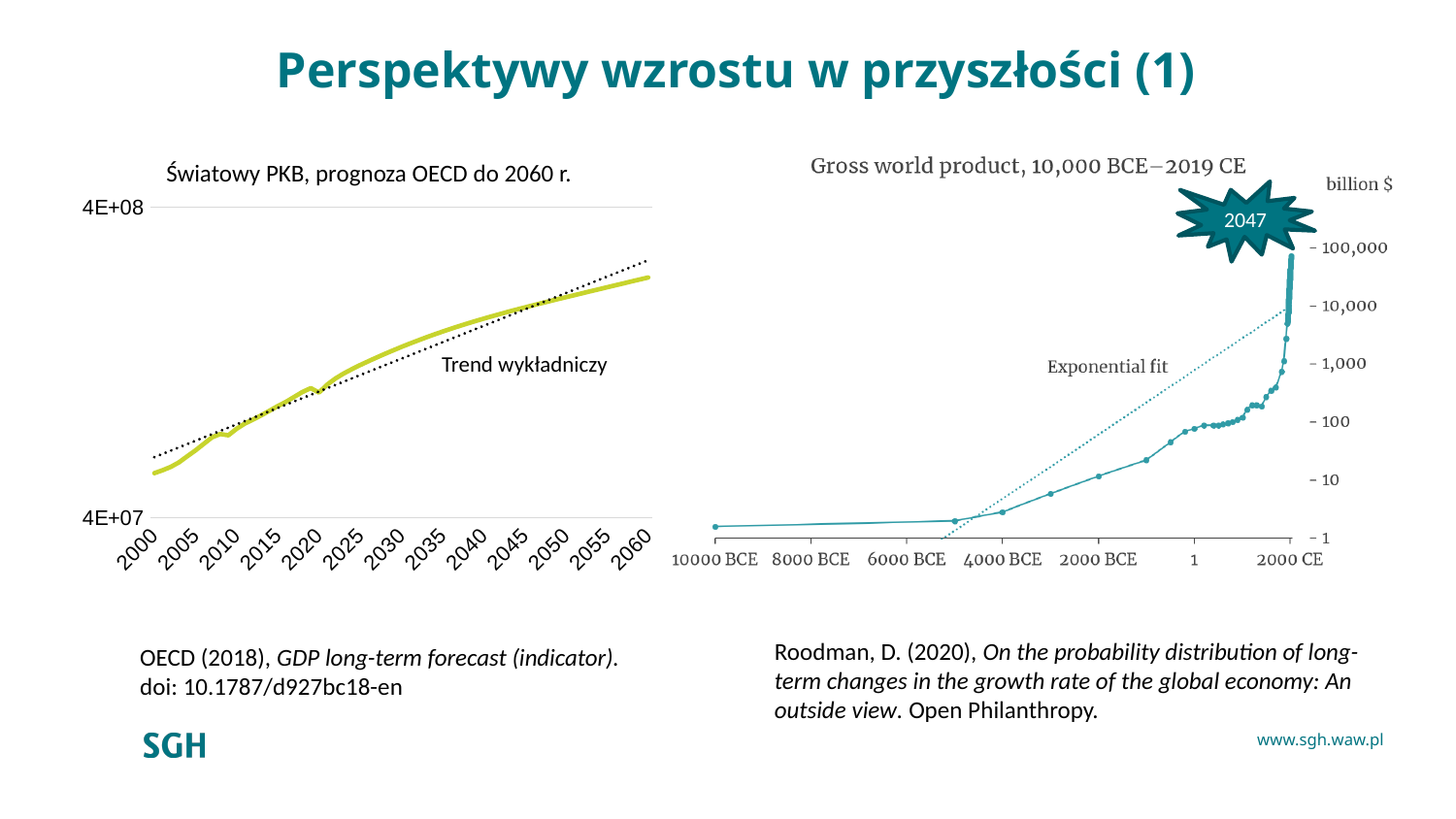
How many tick labels are shown on the y axis of the right chart (Gross world product)? 6 In the right chart (Gross world product), do the values rise or fall from 10000 BCE to 2000 CE? rise What kind of chart is the right chart titled "Gross world product, 10,000 BCE–2019 CE"? line chart How many year labels are shown on the x axis of the left chart (Światowy PKB)? 13 In the left chart (Światowy PKB), do the values rise or fall from 2000 to 2060? rise In the right chart (Gross world product), is the value for 10000 BCE greater or less than 10? less What kind of chart is the left chart titled "Światowy PKB, prognoza OECD do 2060 r."? line chart In the left chart (Światowy PKB), is the value for 2000 greater or less than 4E+07? greater In the right chart (Gross world product), is the value for 2000 CE greater or less than 10,000? greater What label is given to the dotted line in the left chart (Światowy PKB)? Trend wykładniczy What unit is shown on the y axis of the right chart (Gross world product)? billion $